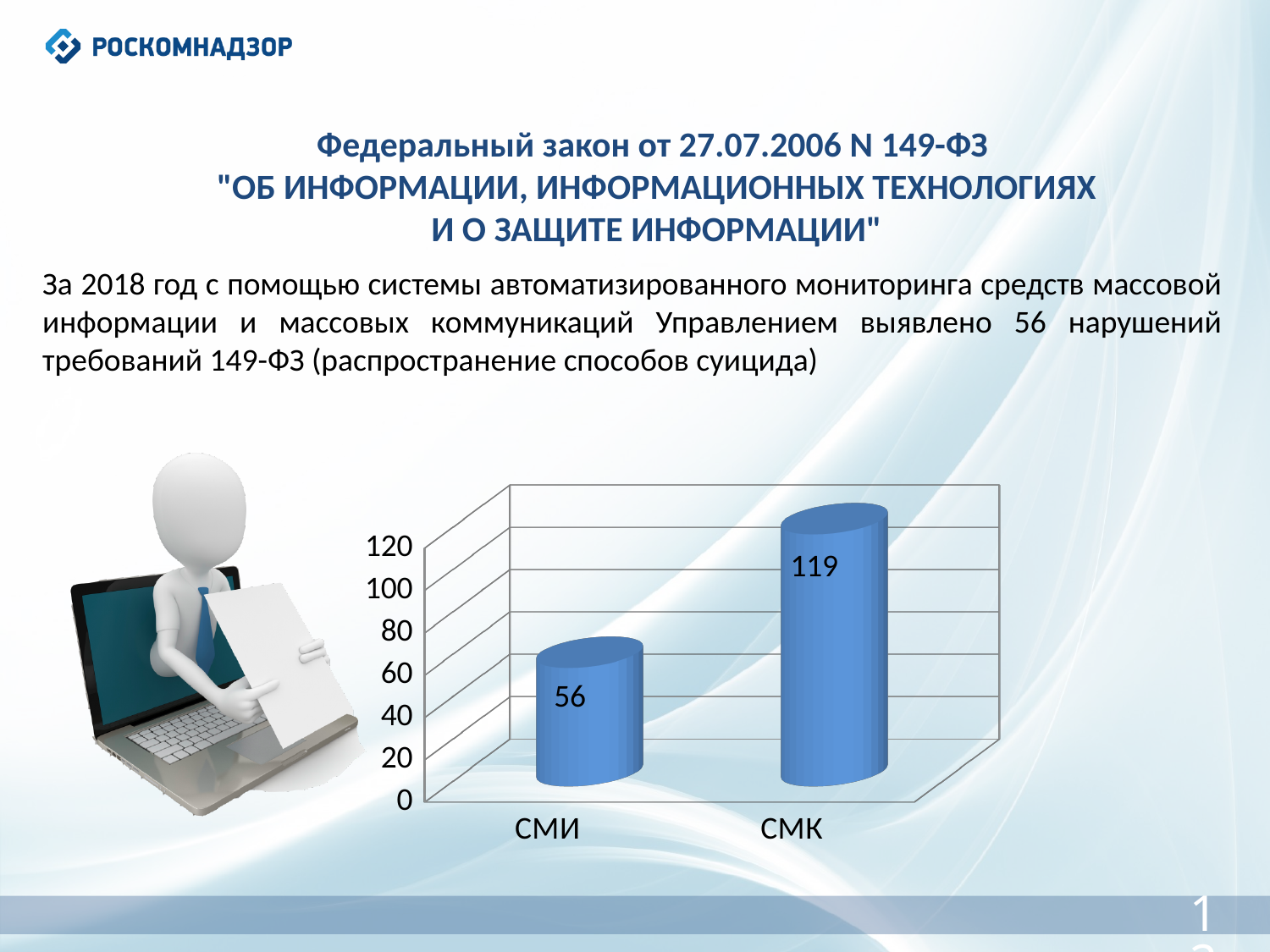
What colour are the bars in the chart? blue Is the value for СМК greater or less than 100? greater Which category has the highest value? СМК What is the maximum value shown on the vertical axis? 120 What is the value for СМК? 119 What is the value for СМИ? 56 What kind of chart is shown on the slide? bar chart Is the value for СМИ greater or less than 80? less Which is larger, the value for СМИ or the value for СМК? СМК How many categories are shown on the chart? 2 What is the difference between the values for СМК and СМИ? 63 Which category has the lowest value? СМИ